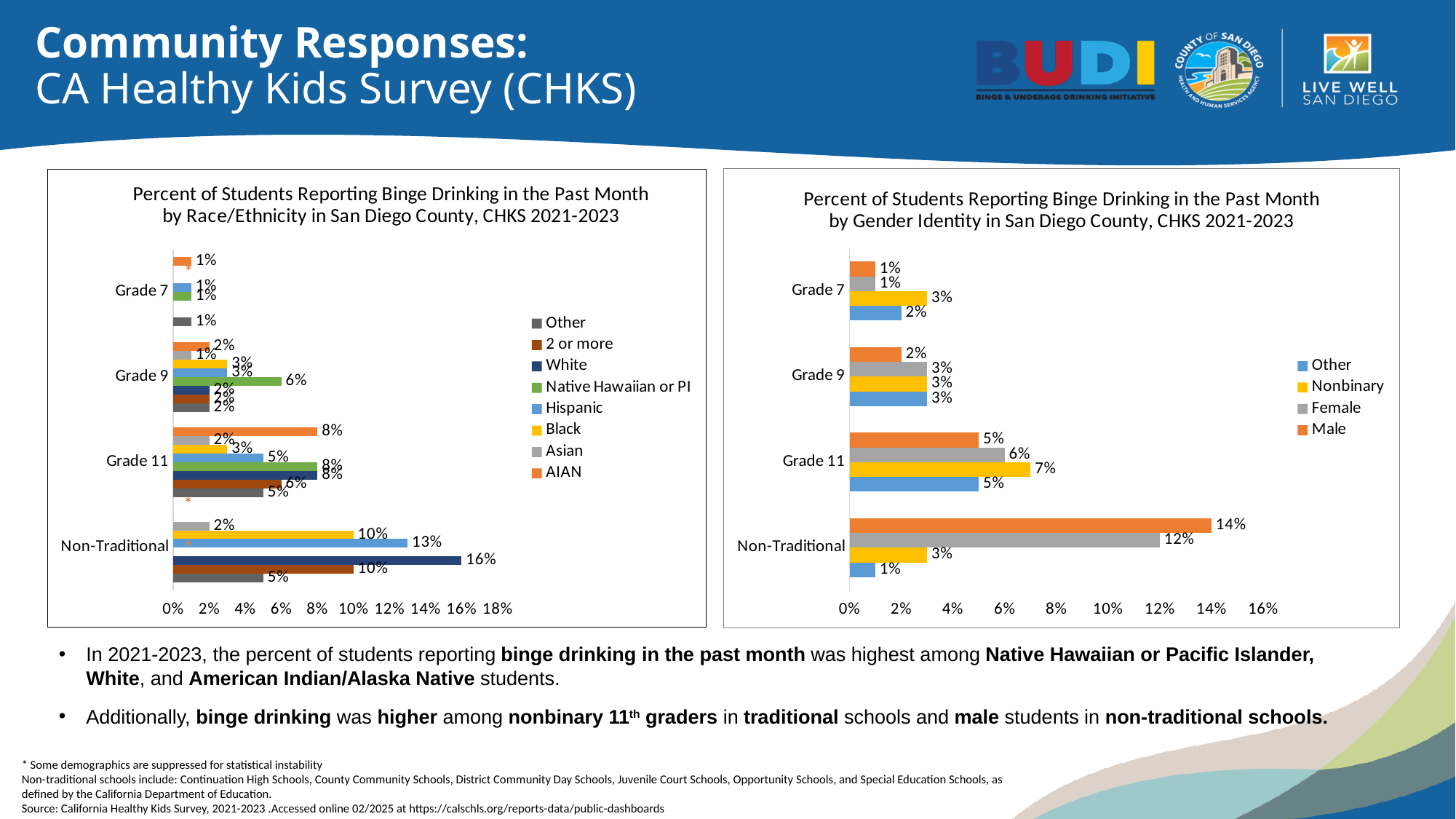
In the chart by Gender Identity, what is the difference between the Male and Female values for Non-Traditional schools? 2% In the chart by Gender Identity, how many series does the legend list? 4 In the chart by Race/Ethnicity, how many series does the legend list? 8 In the chart by Race/Ethnicity, what is the value for Hispanic students in Non-Traditional schools? 13% In the chart by Race/Ethnicity, what is the value for White students in Non-Traditional schools? 16% In the chart by Gender Identity, which gender group has the highest value in Grade 11? Nonbinary In the chart by Gender Identity, which gender group has the lowest value in Non-Traditional schools? Other In the chart by Gender Identity, does the Male value rise or fall from Grade 7 to Non-Traditional? rise In the chart by Gender Identity, what is the value for Nonbinary students in Grade 11? 7% What kind of chart is the chart by Race/Ethnicity? bar chart In the chart by Gender Identity, what is the value for Male students in Non-Traditional schools? 14% In the chart by Gender Identity, what is the value for Female students in Non-Traditional schools? 12%